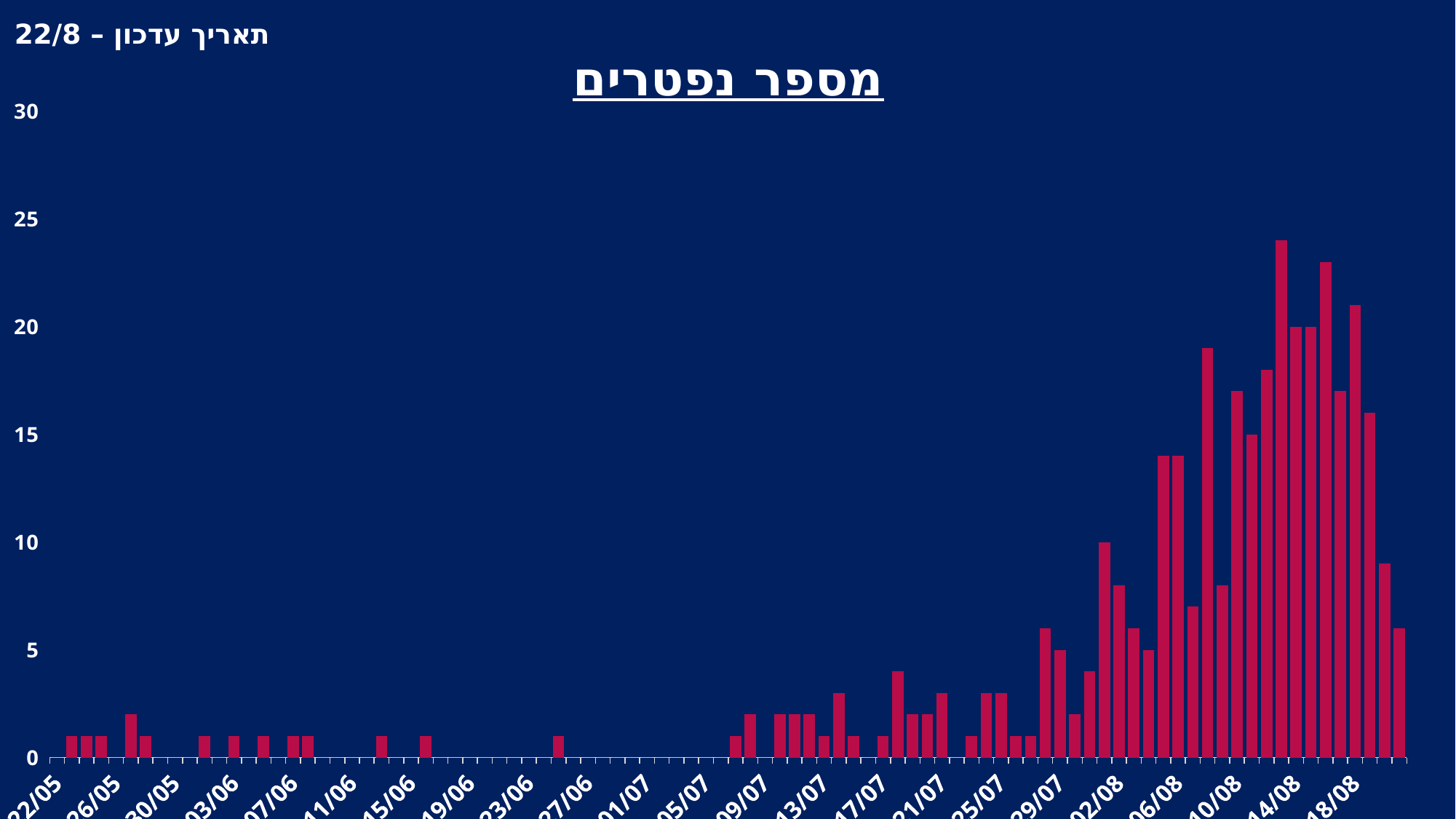
Do the values generally rise or fall from 22/05 to mid-August along the x axis? rise Is the tallest bar in the chart greater or less than 20? greater What is the title of the chart? מספר נפטרים Is the value for 29/07 greater or less than 10? less What kind of chart is shown on the slide? bar chart Is the tallest bar in the chart greater or less than 25? less What colour are the bars in the chart? red Which is larger, the value for 14/08 or the value for 06/08? 14/08